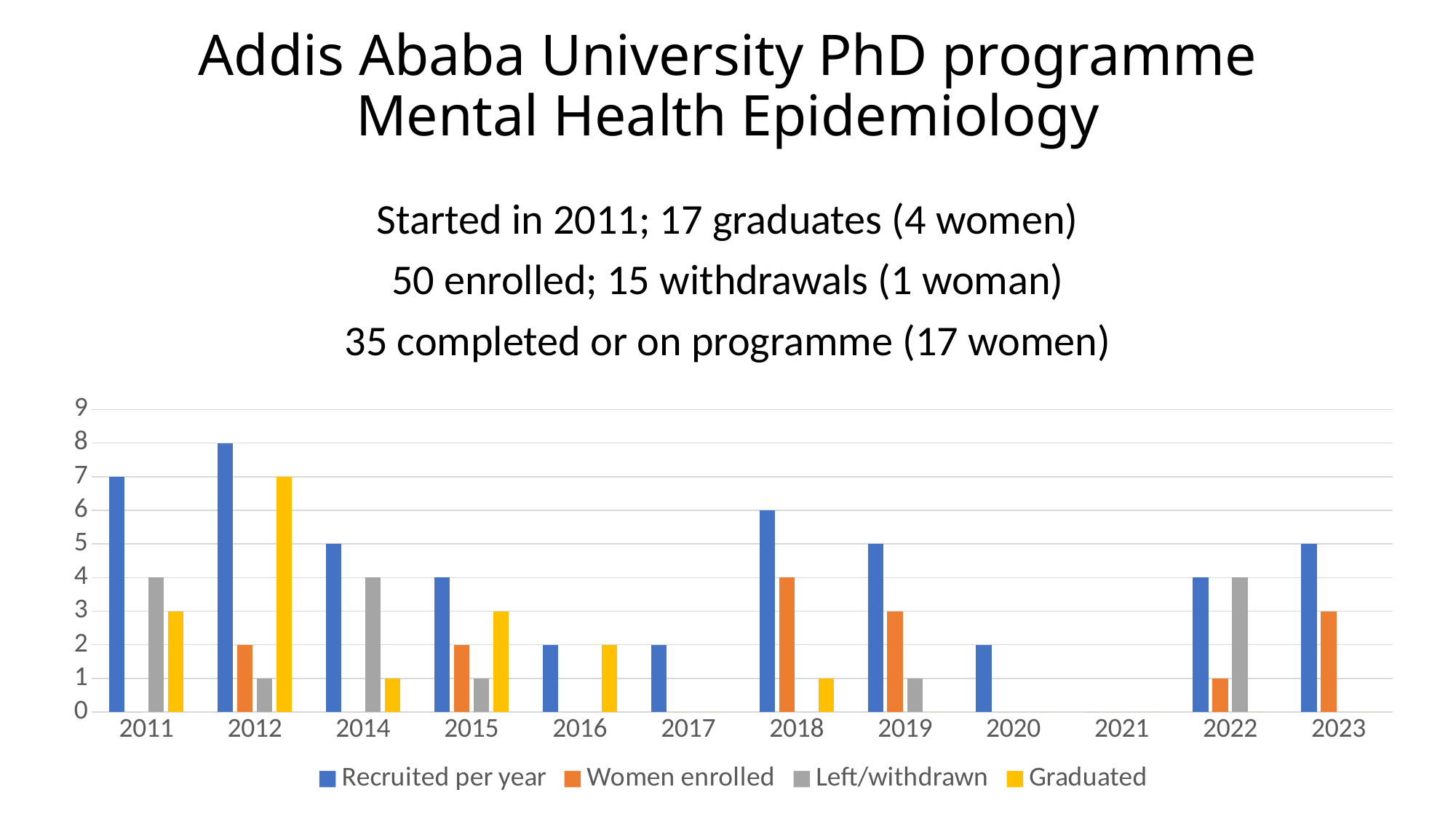
What is the Women enrolled value for 2018? 4 What is the difference between Recruited per year in 2012 and in 2011? 1 What is the Left/withdrawn value for 2022? 4 How many series does the legend list? 4 What kind of chart is shown on the slide? bar chart Which year has the highest Women enrolled value? 2018 What is the Graduated value for 2012? 7 What is the value of Recruited per year for 2012? 8 Which year has the highest Recruited per year value? 2012 Is the Recruited per year value for 2018 greater or less than 5? greater How many years are shown on the x axis? 12 Which is larger, Recruited per year in 2011 or in 2018? 2011